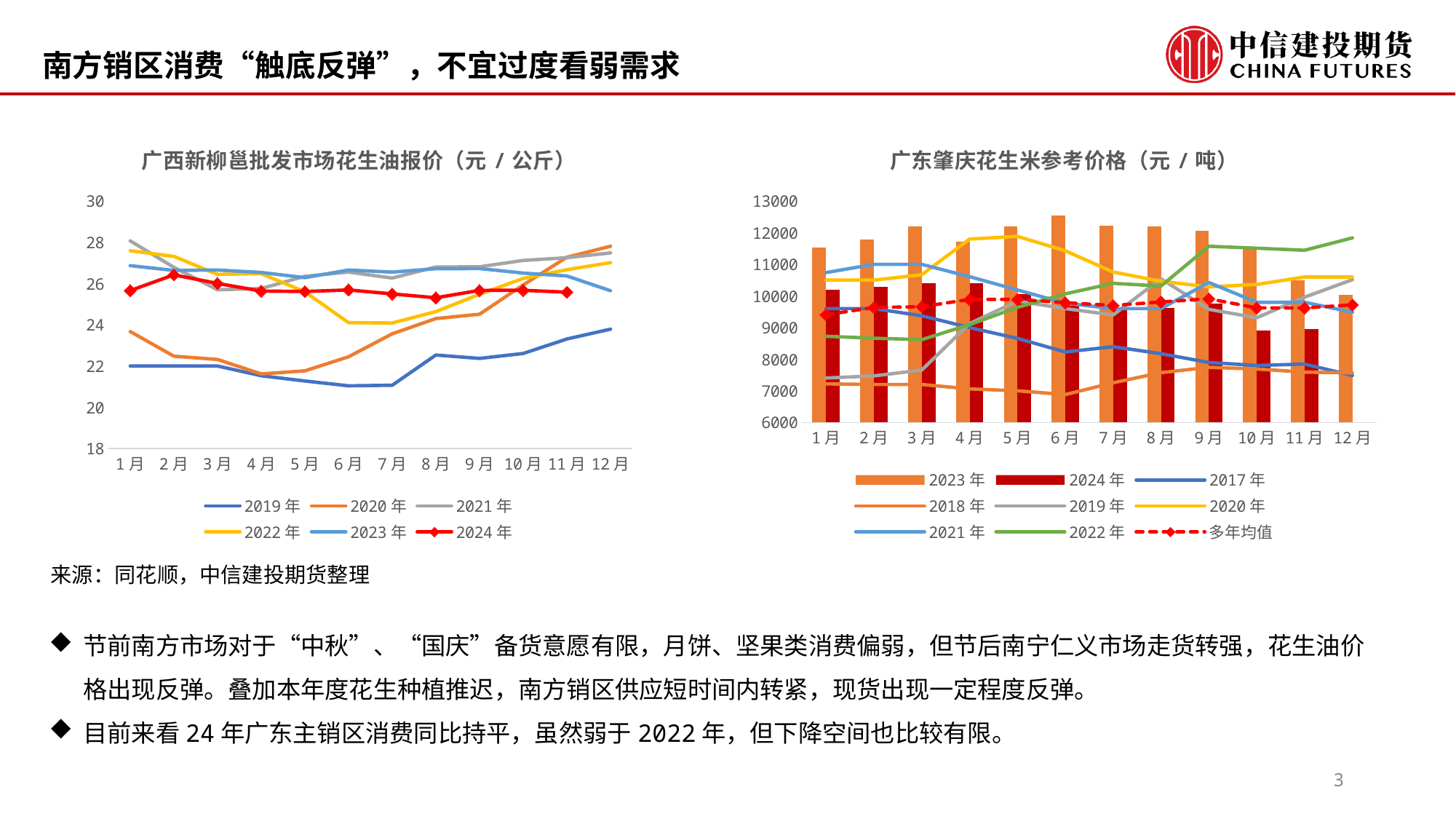
In the left chart (广西新柳邕批发市场花生油报价), which is higher in 1月, 2024年 or 2019年? 2024年 In the right chart (广东肇庆花生米参考价格), which series is drawn as a red dashed line with diamond markers? 多年均值 In the right chart (广东肇庆花生米参考价格), is the 2023年 bar for 6月 greater or less than 12000? greater What kind of chart is the left chart titled 广西新柳邕批发市场花生油报价（元／公斤）? line chart In the left chart (广西新柳邕批发市场花生油报价), is the value for 2019年 in 6月 greater or less than 22? less How many series does the legend of the right chart (广东肇庆花生米参考价格) list? 9 In the right chart (广东肇庆花生米参考价格), is the 2024年 bar for 10月 greater or less than 10000? less In the left chart (广西新柳邕批发市场花生油报价), does the 2019年 line rise or fall from 7月 to 12月? rise How many months are shown on the x axis of the left chart (广西新柳邕批发市场花生油报价)? 12 How many series does the legend of the left chart (广西新柳邕批发市场花生油报价) list? 6 In the right chart (广东肇庆花生米参考价格), which month has the highest 2023年 bar? 6月